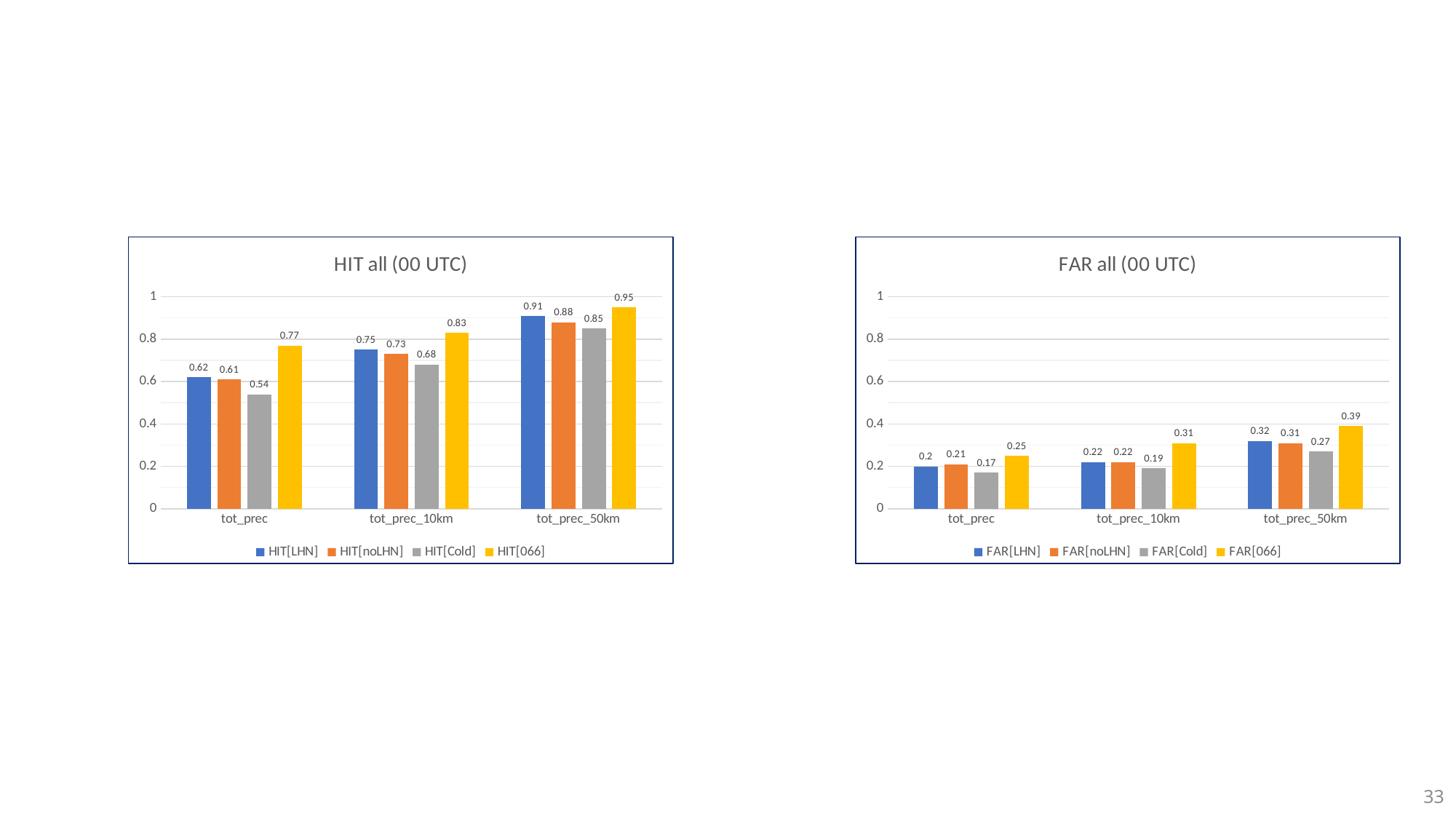
In the 'FAR all (00 UTC)' chart, what is the value of FAR[066] for tot_prec_50km? 0.39 In the 'FAR all (00 UTC)' chart, what is the difference between FAR[066] and FAR[LHN] for tot_prec_50km? 0.07 In the 'FAR all (00 UTC)' chart, what is the value of FAR[Cold] for tot_prec_10km? 0.19 What kind of chart is the 'FAR all (00 UTC)' chart? Bar chart In the 'HIT all (00 UTC)' chart, which is larger for tot_prec_10km: HIT[LHN] or HIT[Cold]? HIT[LHN] In the 'HIT all (00 UTC)' chart, what is the value of HIT[066] for tot_prec_10km? 0.83 In the 'HIT all (00 UTC)' chart, which series has the highest value for tot_prec_50km? HIT[066] In the 'HIT all (00 UTC)' chart, what is the value of HIT[Cold] for tot_prec? 0.54 In the 'HIT all (00 UTC)' chart, what is the difference between HIT[066] and HIT[Cold] for tot_prec? 0.23 In the 'FAR all (00 UTC)' chart, which series has the lowest value for tot_prec? FAR[Cold] How many categories are shown on the x axis of the 'HIT all (00 UTC)' chart? 3 How many series does the legend of the 'FAR all (00 UTC)' chart list? 4